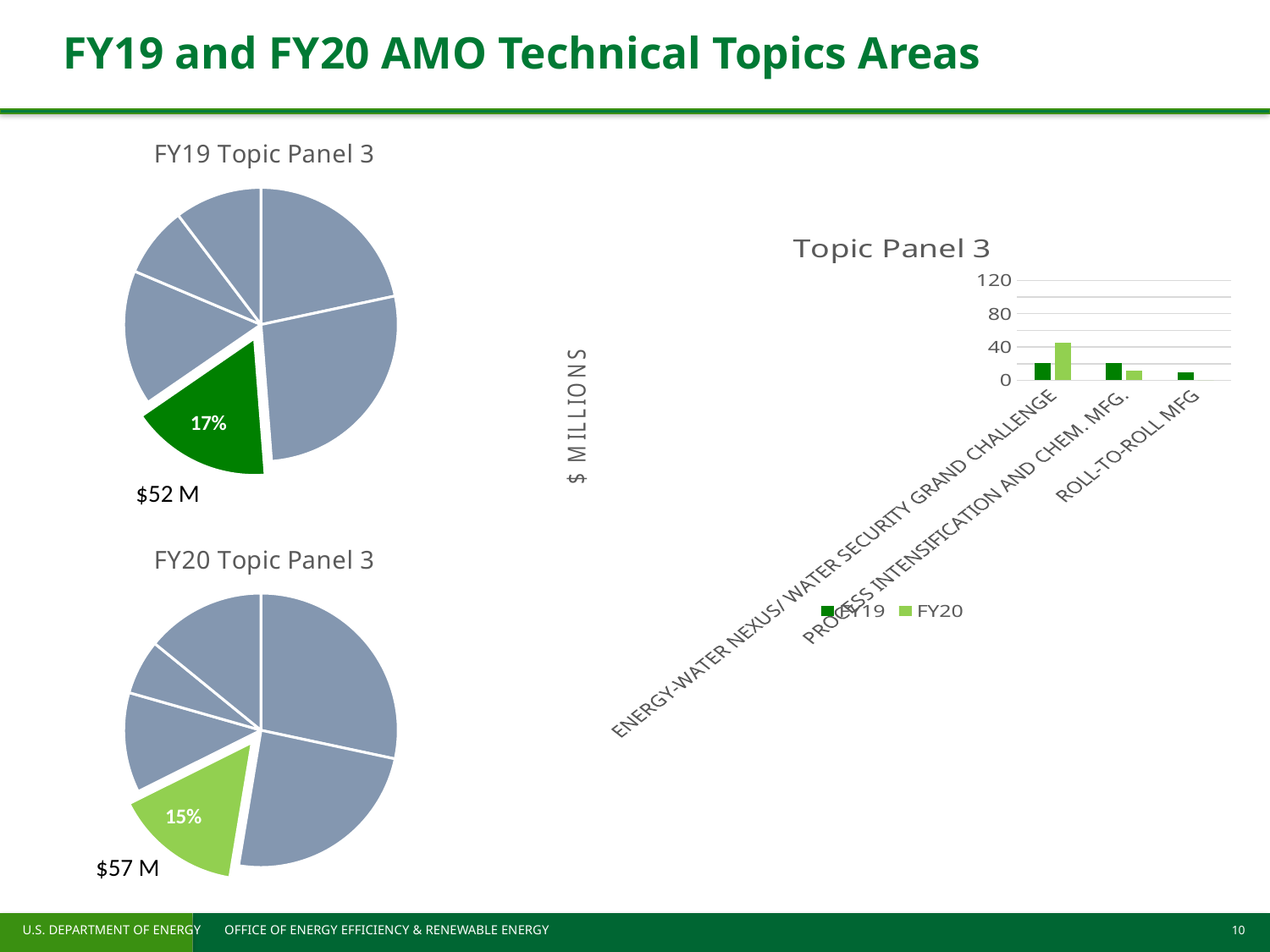
In the Topic Panel 3 bar chart, how many categories are shown on the x axis? 3 What dollar amount is labelled below the FY20 Topic Panel 3 pie chart? $57 M In the FY19 Topic Panel 3 pie chart, what percentage is shown on the highlighted green slice? 17% In the FY20 Topic Panel 3 pie chart, what percentage is shown on the highlighted green slice? 15% In the Topic Panel 3 bar chart, which bar is the tallest? FY20 for Energy-Water Nexus/ Water Security Grand Challenge What kind of chart is the Topic Panel 3 chart on the right of the slide? bar chart In the Topic Panel 3 bar chart, how many series does the legend list? 2 What is the y-axis title of the Topic Panel 3 bar chart? $ MILLIONS In the Topic Panel 3 bar chart, is the FY20 value for Energy-Water Nexus/ Water Security Grand Challenge greater or less than 80? less In the Topic Panel 3 bar chart, which is larger for Process Intensification and Chem. Mfg., the FY19 bar or the FY20 bar? FY19 What dollar amount is labelled below the FY19 Topic Panel 3 pie chart? $52 M Comparing the two pie charts, which year has the larger highlighted Topic Panel 3 share, FY19 or FY20? FY19